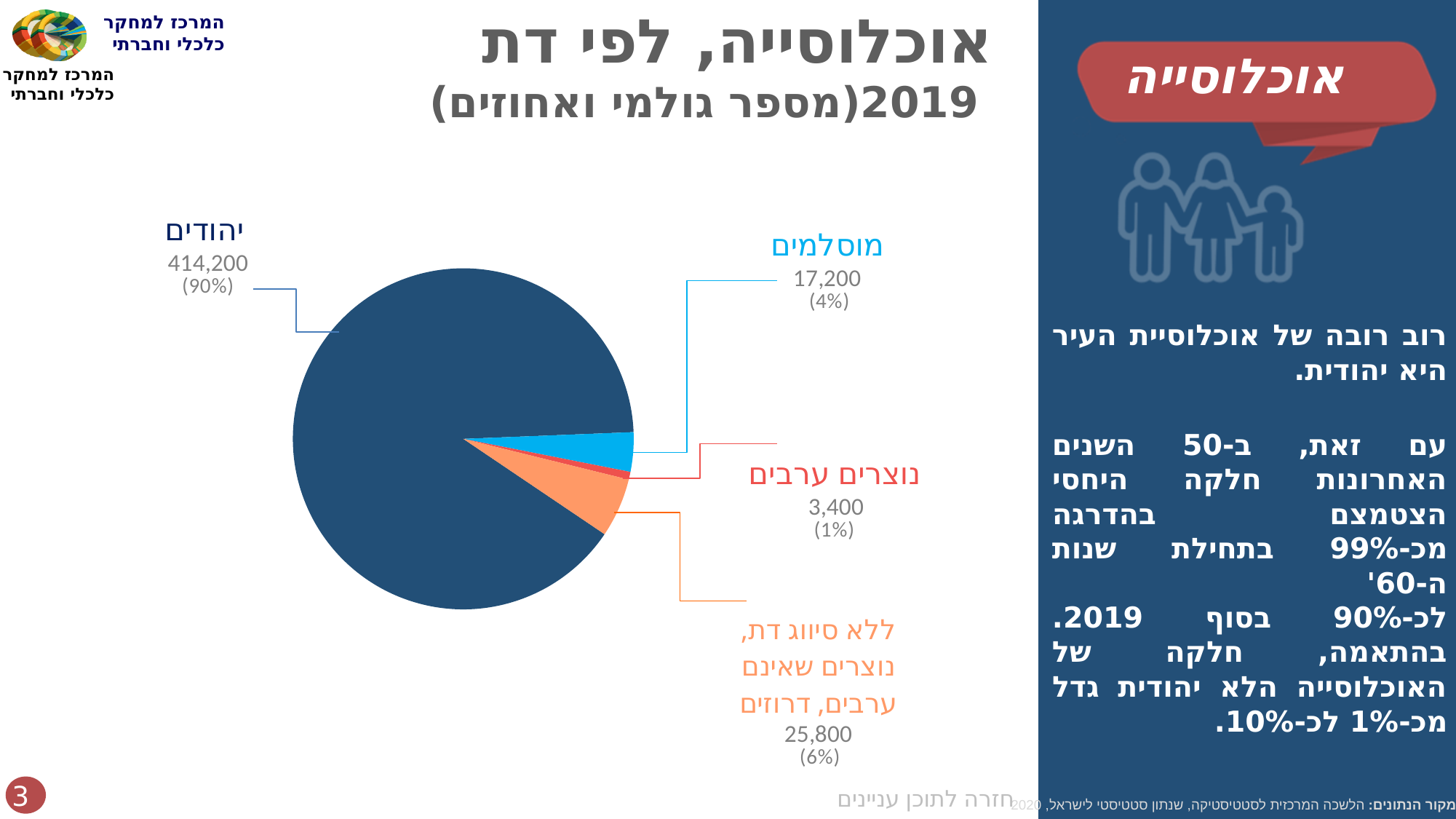
Which category has the largest slice of the pie? יהודים How many slices does the pie chart have? 4 What type of chart is shown on the slide? pie chart Which is larger, the value for מוסלמים or the value for ללא סיווג דת, נוצרים שאינם ערבים, דרוזים? ללא סיווג דת, נוצרים שאינם ערבים, דרוזים What is the value shown for נוצרים ערבים? 3,400 What is the value shown for יהודים? 414,200 What is the value shown for מוסלמים? 17,200 What share of the pie does יהודים represent? 90% Which category has the smallest slice of the pie? נוצרים ערבים What is the value shown for ללא סיווג דת, נוצרים שאינם ערבים, דרוזים? 25,800 What share of the pie does מוסלמים represent? 4% What is the difference between the values for מוסלמים and נוצרים ערבים? 13,800